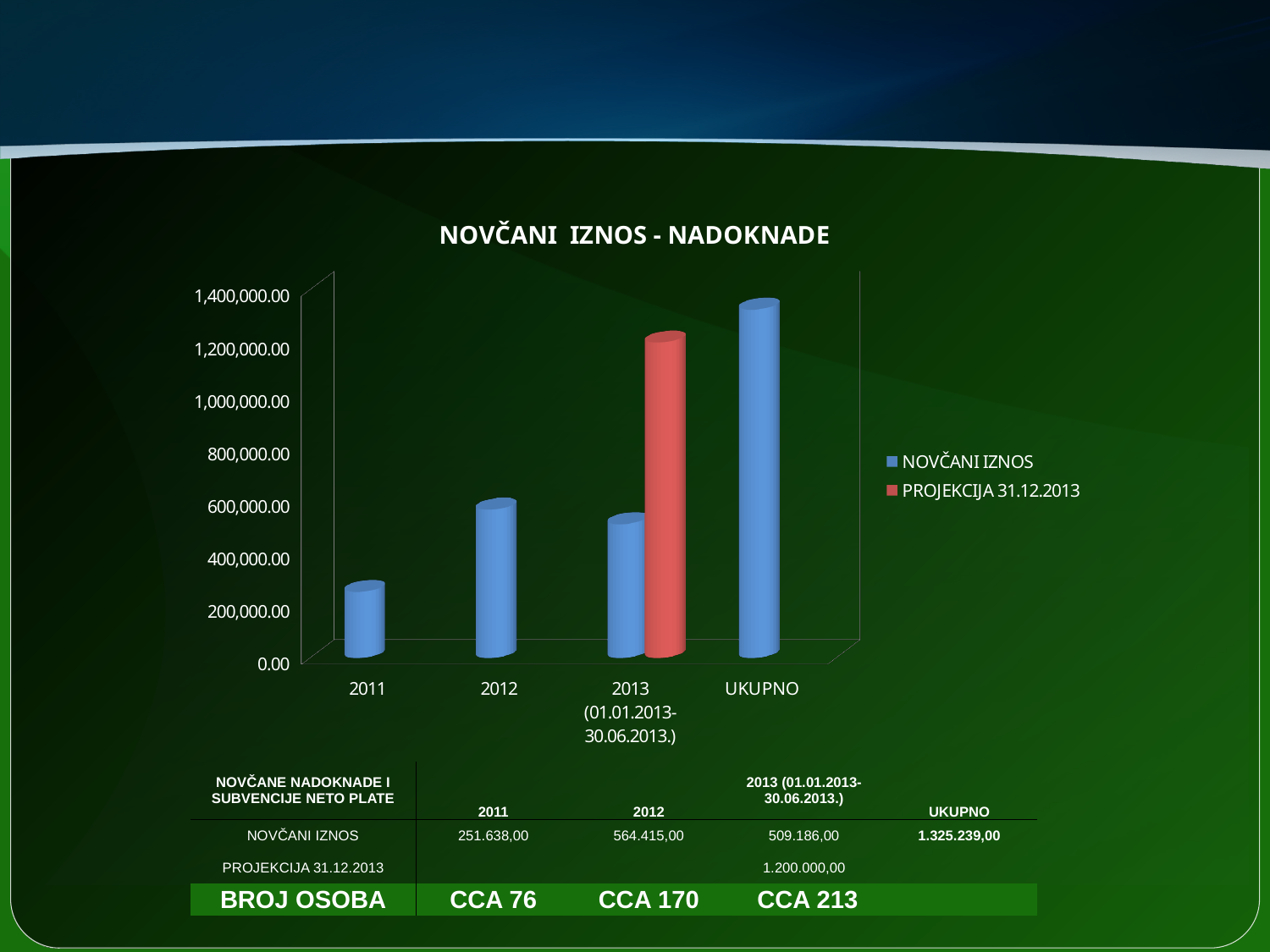
Which category has the lowest NOVČANI IZNOS value? 2011 How many categories are shown along the x axis of the chart? 4 What is the PROJEKCIJA 31.12.2013 value for 2013 (01.01.2013-30.06.2013.)? 1.200.000,00 What kind of chart is shown on the slide? bar chart Which has the larger NOVČANI IZNOS value, 2012 or 2013 (01.01.2013-30.06.2013.)? 2012 What is the title of the chart? NOVČANI IZNOS - NADOKNADE What is the NOVČANI IZNOS value for 2012? 564.415,00 What is the NOVČANI IZNOS value for 2011? 251.638,00 What is the difference between the NOVČANI IZNOS values for 2012 and 2011? 312.777,00 What is the NOVČANI IZNOS value for UKUPNO? 1.325.239,00 Which category has the highest NOVČANI IZNOS value? UKUPNO How many series does the chart legend list? 2